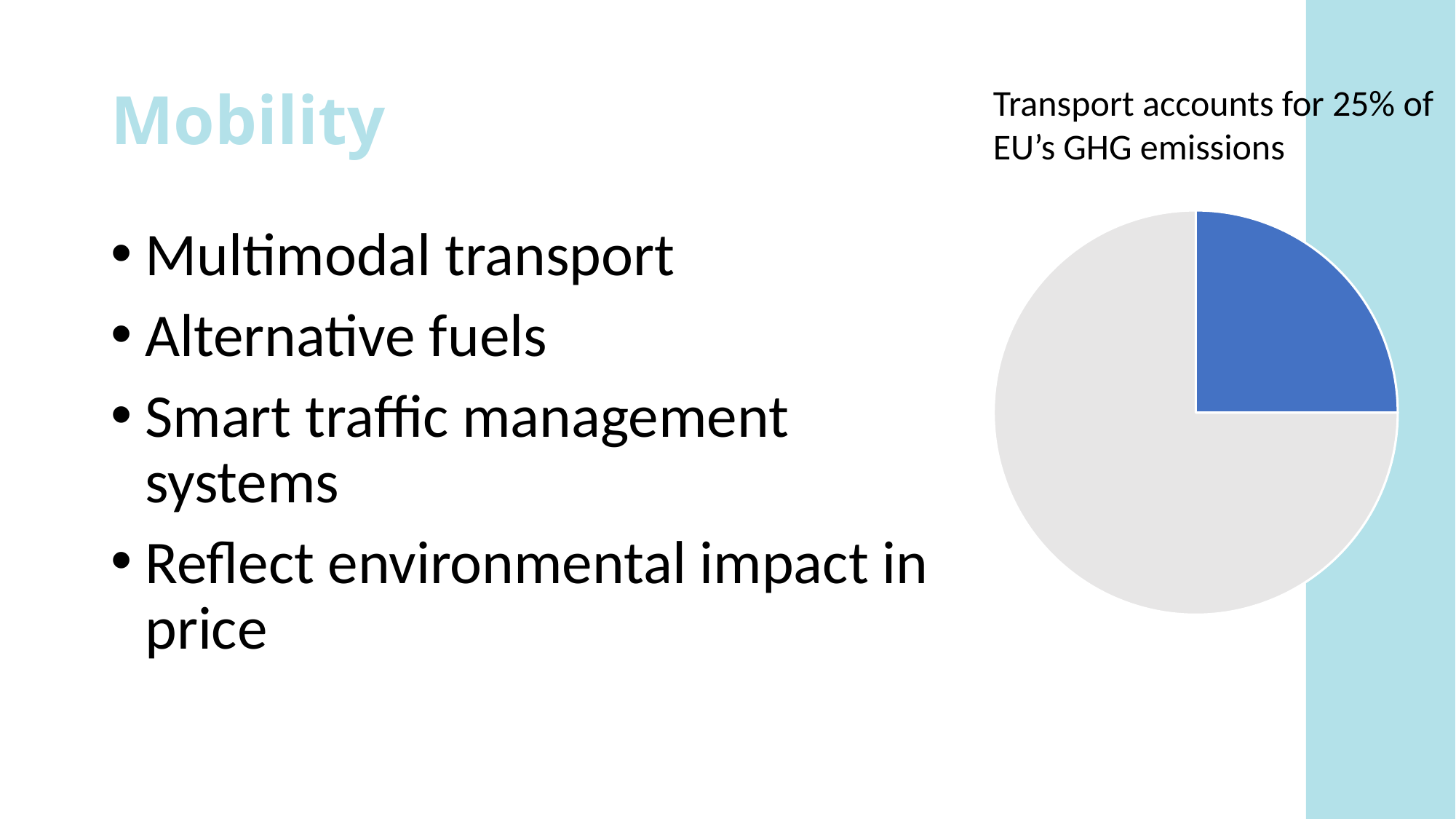
What share of the pie does the grey slice represent, given that transport accounts for 25%? 75% What colour is the slice representing transport's share of EU GHG emissions? blue How many slices does the pie chart have? 2 Which slice of the pie chart is larger, the blue slice or the grey slice? the grey slice Is the share represented by the blue slice greater or less than 50%? less What text is shown above the pie chart? Transport accounts for 25% of EU's GHG emissions According to the slide, what share of the EU's GHG emissions does transport account for? 25% What kind of chart is shown on the slide? pie chart